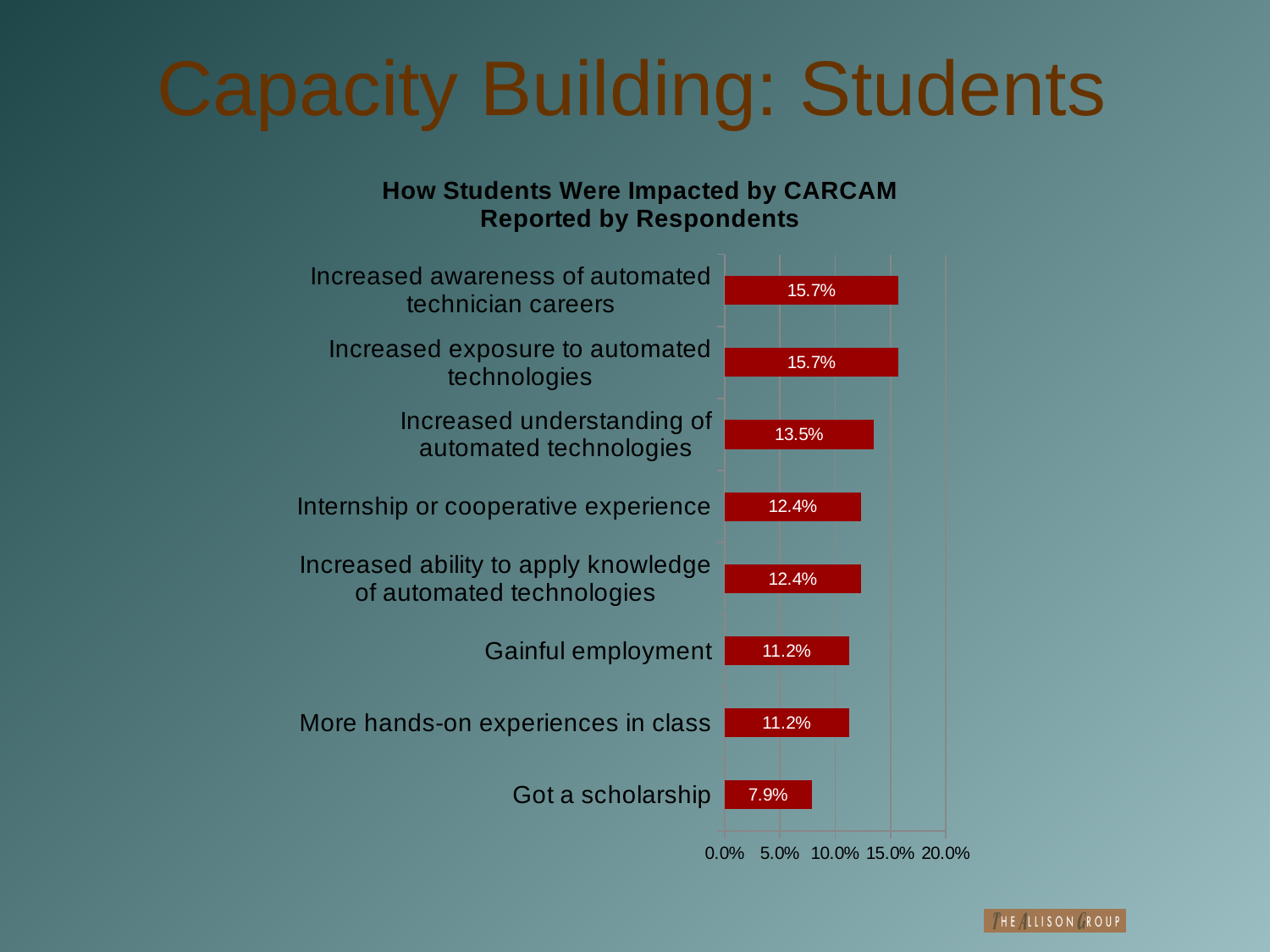
How many categories are shown in the chart? 8 Which category has the lowest value? Got a scholarship What is the value for "Got a scholarship"? 7.9% What is the difference between "Increased understanding of automated technologies" and "Gainful employment"? 2.3% What kind of chart is shown on the slide? Bar chart What is the difference between "Increased awareness of automated technician careers" and "Got a scholarship"? 7.8% Which is larger, "Increased exposure to automated technologies" or "More hands-on experiences in class"? Increased exposure to automated technologies What is the title of the chart? How Students Were Impacted by CARCAM Reported by Respondents What is the value for "Increased understanding of automated technologies"? 13.5% What is the value for "Internship or cooperative experience"? 12.4% What is the value for "Gainful employment"? 11.2% Is the value for "Got a scholarship" greater or less than 10.0%? less